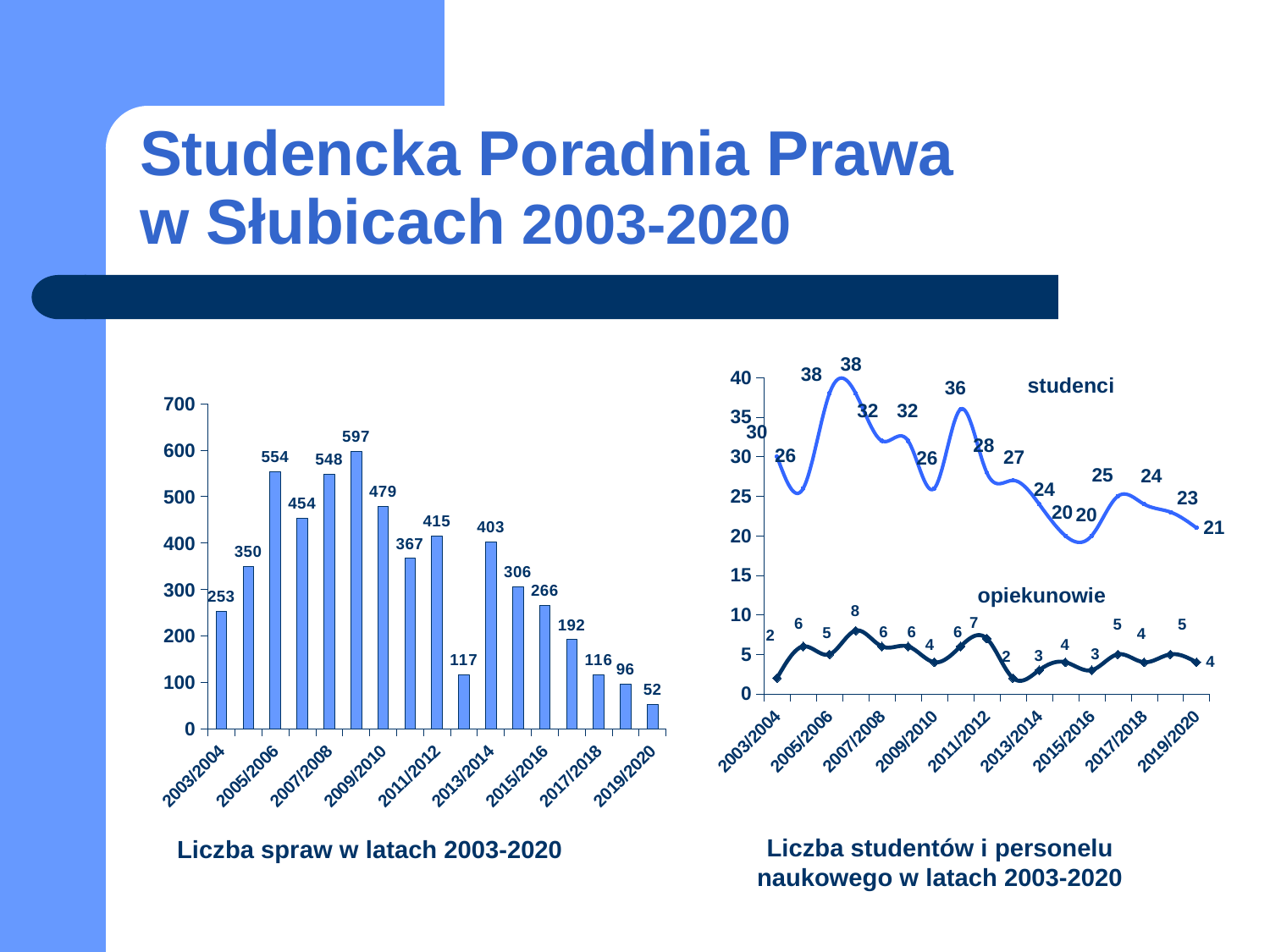
What type of chart is the left chart, 'Liczba spraw w latach 2003-2020'? bar chart In the left chart 'Liczba spraw w latach 2003-2020', what is the value for 2003/2004? 253 In the left chart 'Liczba spraw w latach 2003-2020', what is the highest value shown on any bar? 597 In the right chart 'Liczba studentów i personelu naukowego w latach 2003-2020', what is the value of the studenci series for 2019/2020? 21 How many bars are there in the left chart 'Liczba spraw w latach 2003-2020'? 17 In the left chart 'Liczba spraw w latach 2003-2020', which is larger, the value for 2011/2012 or the value for 2015/2016? 2011/2012 How many series are plotted in the right chart 'Liczba studentów i personelu naukowego w latach 2003-2020'? 2 In the right chart 'Liczba studentów i personelu naukowego w latach 2003-2020', what is the value of the opiekunowie series for 2011/2012? 7 In the left chart 'Liczba spraw w latach 2003-2020', what is the value for 2019/2020? 52 In the left chart 'Liczba spraw w latach 2003-2020', what is the difference between the values for 2005/2006 and 2007/2008? 6 In the right chart 'Liczba studentów i personelu naukowego w latach 2003-2020', what is the difference between the studenci value and the opiekunowie value for 2003/2004? 28 In the left chart 'Liczba spraw w latach 2003-2020', which labelled year has the lowest value? 2019/2020